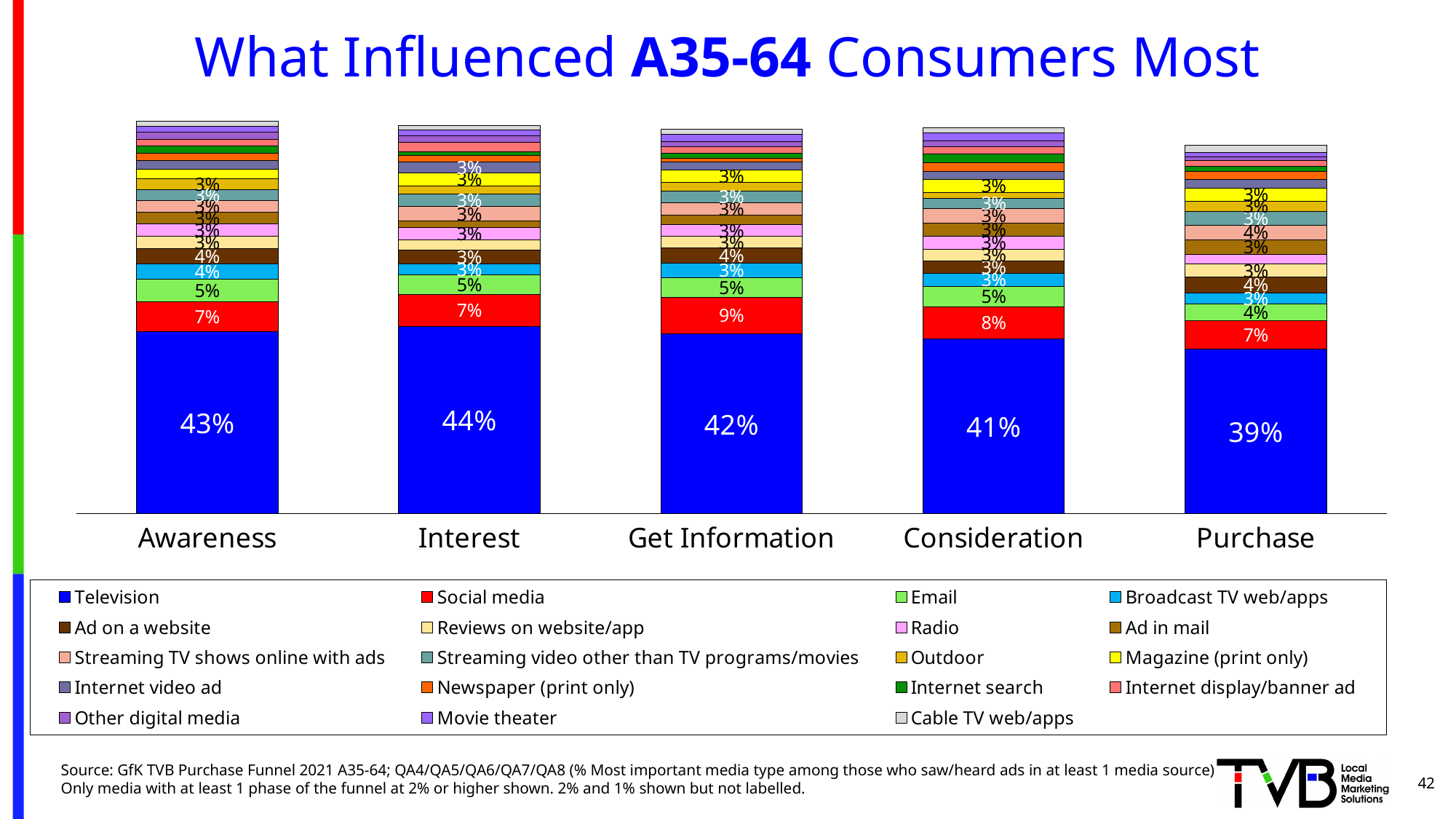
What is the Television value for the Purchase stage? 39% What percentage of A35-64 consumers cited Television as most influential at the Awareness stage? 43% How many percentage points higher is the Television value at Interest than at Purchase? 5 percentage points How many funnel stages are shown on the x axis? 5 At which funnel stage is the Television share highest? Interest From Interest to Purchase, does the Television value rise or fall? Fall How many media types does the legend list? 19 What is the Social media value at the Get Information stage? 9% What kind of chart is shown on the slide? Stacked bar chart What is the Email value at the Purchase stage? 4% Is the Social media value larger at Get Information or at Consideration? Get Information At which funnel stage is the Television share lowest? Purchase